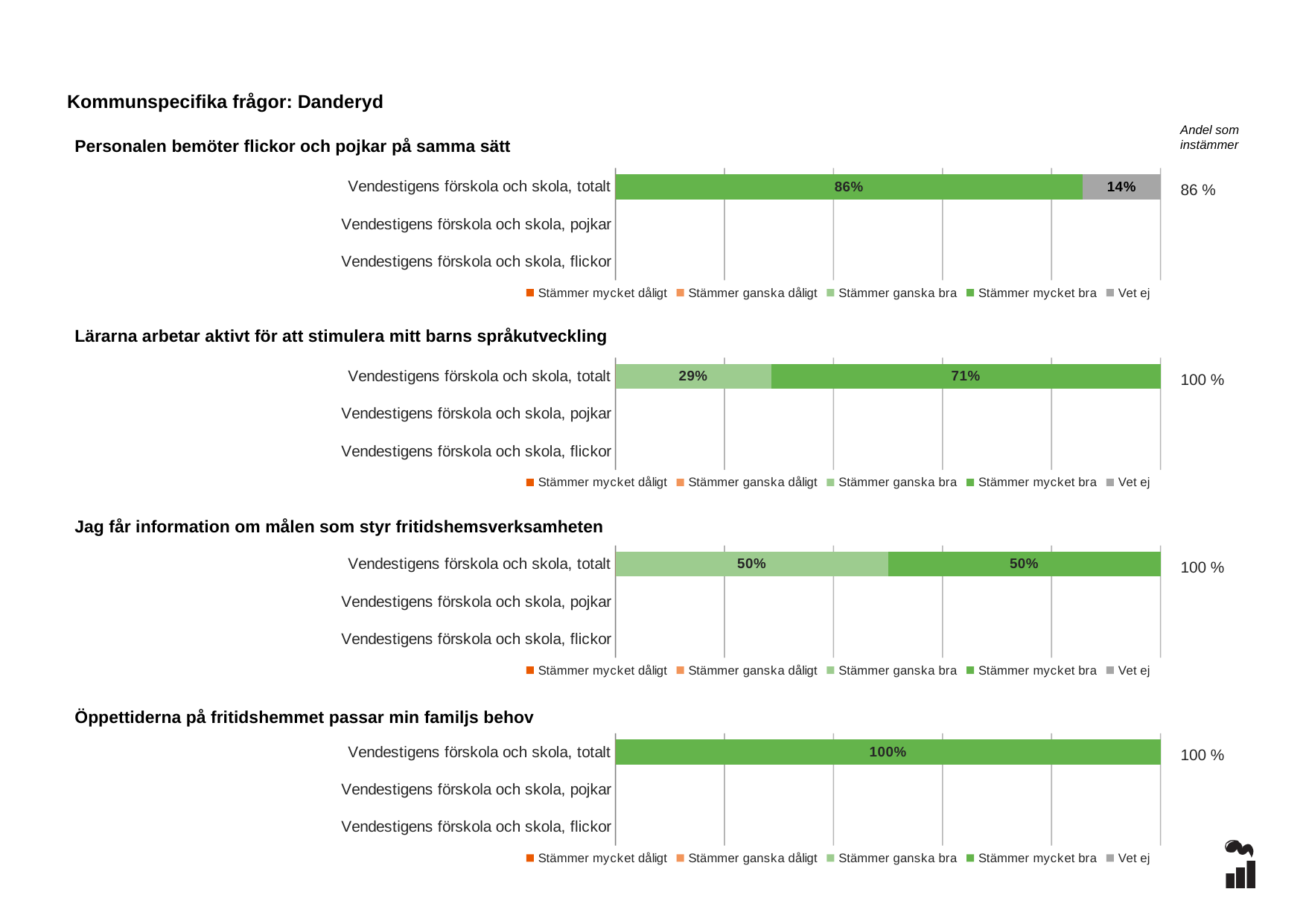
In the chart 'Öppettiderna på fritidshemmet passar min familjs behov', what is the value of 'Stämmer mycket bra' for 'Vendestigens förskola och skola, totalt'? 100% In the chart 'Personalen bemöter flickor och pojkar på samma sätt', which is larger for 'Vendestigens förskola och skola, totalt': 'Stämmer mycket bra' or 'Vet ej'? Stämmer mycket bra In the chart 'Lärarna arbetar aktivt för att stimulera mitt barns språkutveckling', what is the value of 'Stämmer mycket bra' for 'Vendestigens förskola och skola, totalt'? 71% In the chart 'Personalen bemöter flickor och pojkar på samma sätt', what is the value of 'Vet ej' for 'Vendestigens förskola och skola, totalt'? 14% What kind of chart is 'Lärarna arbetar aktivt för att stimulera mitt barns språkutveckling'? Stacked bar chart How many categories are shown on the y axis of the chart 'Jag får information om målen som styr fritidshemsverksamheten'? 3 How many series does the legend list in the chart 'Öppettiderna på fritidshemmet passar min familjs behov'? 5 In the chart 'Personalen bemöter flickor och pojkar på samma sätt', what is the 'Andel som instämmer' value shown for 'Vendestigens förskola och skola, totalt'? 86 % In the chart 'Lärarna arbetar aktivt för att stimulera mitt barns språkutveckling', what is the value of 'Stämmer ganska bra' for 'Vendestigens förskola och skola, totalt'? 29% In the chart 'Lärarna arbetar aktivt för att stimulera mitt barns språkutveckling', what is the difference between 'Stämmer mycket bra' and 'Stämmer ganska bra' for 'Vendestigens förskola och skola, totalt'? 42% In the chart 'Personalen bemöter flickor och pojkar på samma sätt', what is the value of 'Stämmer mycket bra' for 'Vendestigens förskola och skola, totalt'? 86% In the chart 'Jag får information om målen som styr fritidshemsverksamheten', what is the value of 'Stämmer ganska bra' for 'Vendestigens förskola och skola, totalt'? 50%